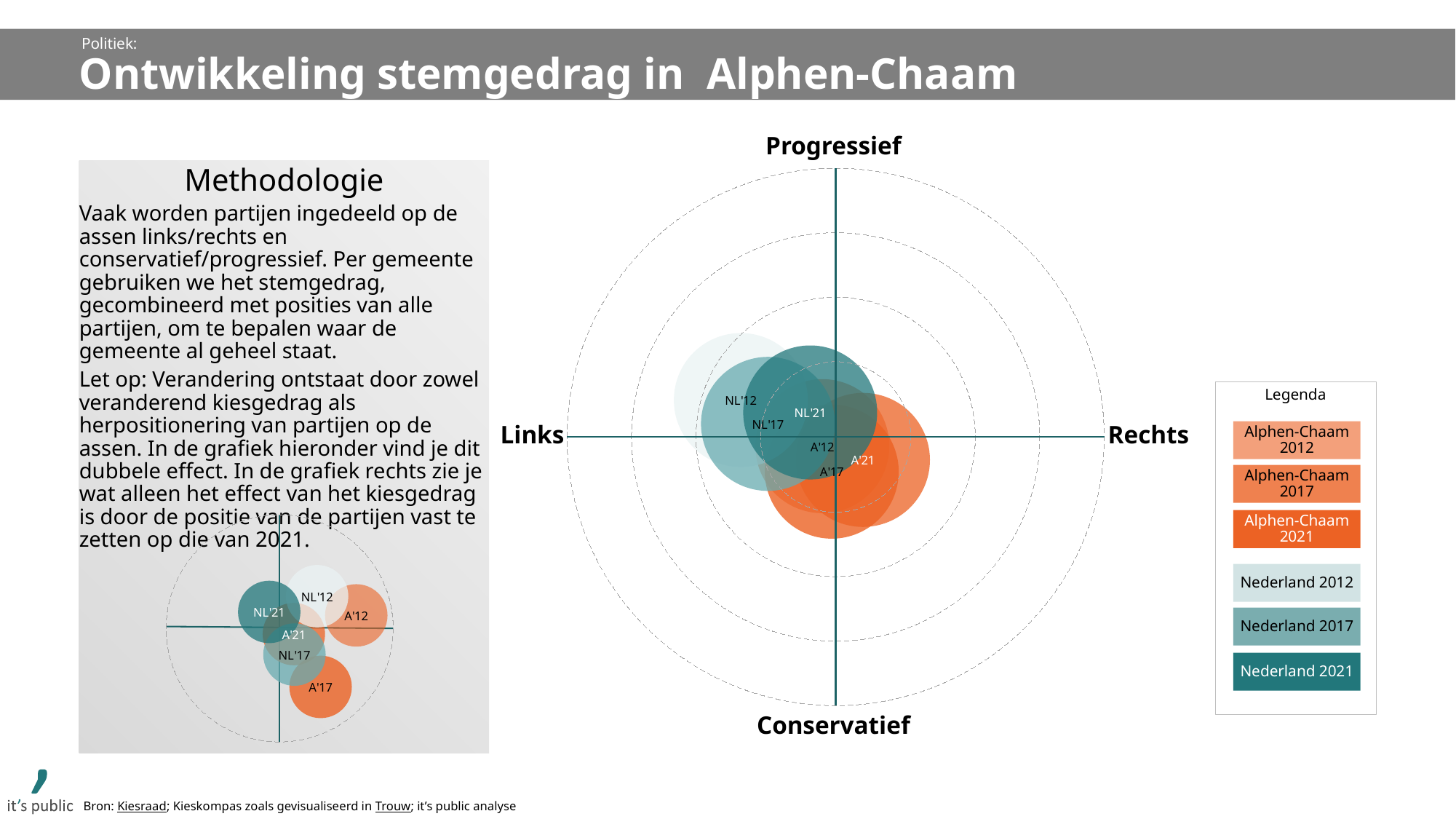
In the large chart on the right, is the A'21 bubble to the left or to the right of the NL'21 bubble? right In the small chart inside the Methodologie box, which bubble is positioned furthest to the right? A'12 In the large chart on the right, are the Nederland bubbles centred on the Progressief or the Conservatief side of the horizontal axis? Progressief How many entries does the legend (Legenda) list? 6 In the large chart on the right, what are the labels at the left and right ends of the horizontal axis? Links and Rechts In the small chart inside the Methodologie box, which bubble is positioned lowest (most Conservatief)? A'17 How many labelled bubbles are plotted in the large chart on the right? 6 In the large chart on the right, what are the labels at the top and bottom of the vertical axis? Progressief and Conservatief In the small chart inside the Methodologie box, which bubble is positioned furthest to the left? NL'21 In the large chart on the right, is the A'21 bubble further to the right than the A'12 bubble? yes What kind of chart is the large chart on the right of the slide? bubble chart